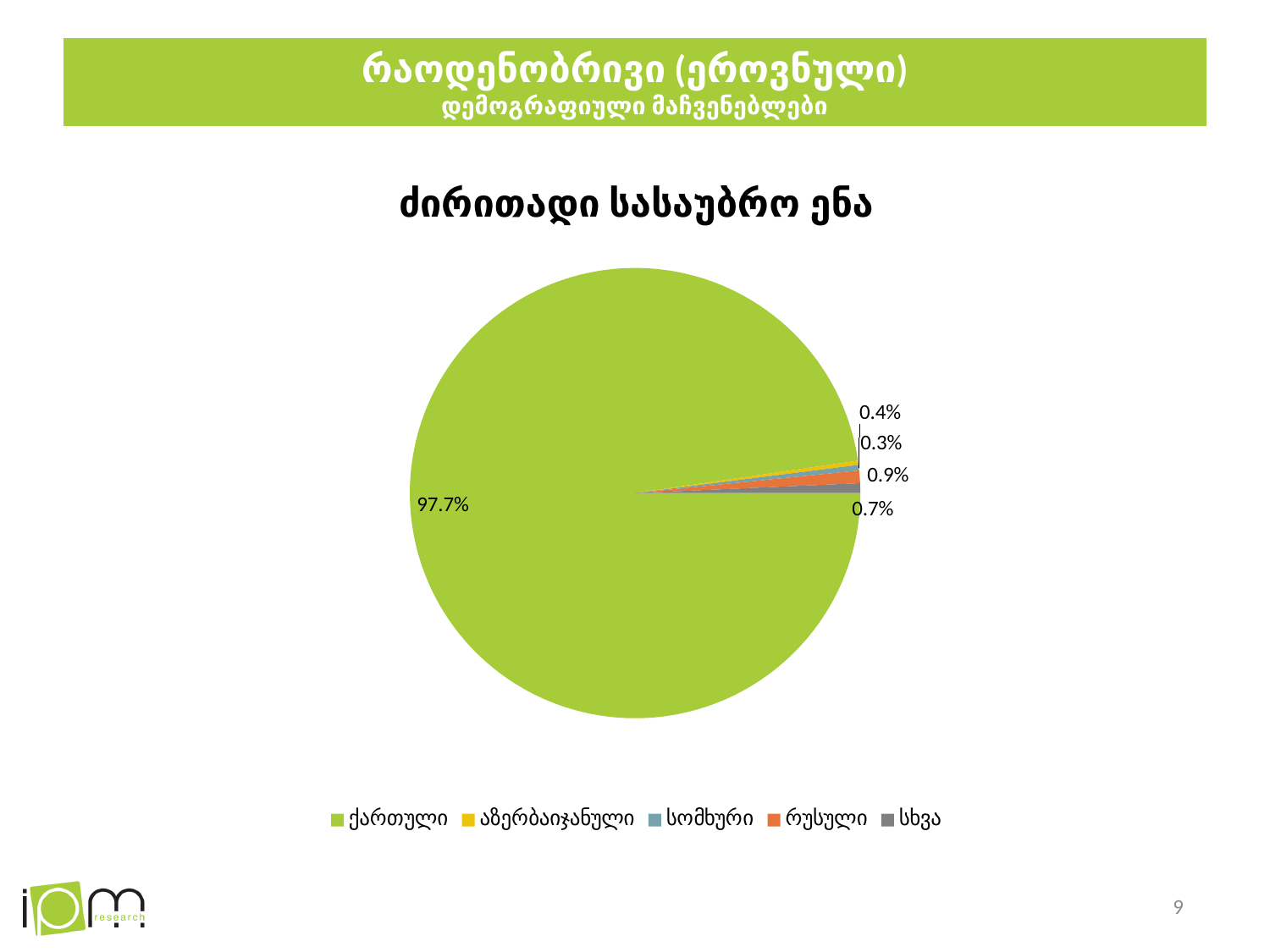
Which is larger, the value for რუსული or the value for სხვა? რუსული What share of the pie does ქართული have? 97.7% What is the title of the chart? ძირითადი სასაუბრო ენა Which category has the smallest slice of the pie? აზერბაიჯანული What is the value for რუსული? 0.9% Which category has the largest slice of the pie? ქართული What kind of chart is shown on the slide? pie chart What is the value for სხვა? 0.7% How many categories does the legend list? 5 What is the value for აზერბაიჯანული? 0.3% What is the difference between the value for ქართული and the value for რუსული? 96.8 percentage points What is the value for სომხური? 0.4%